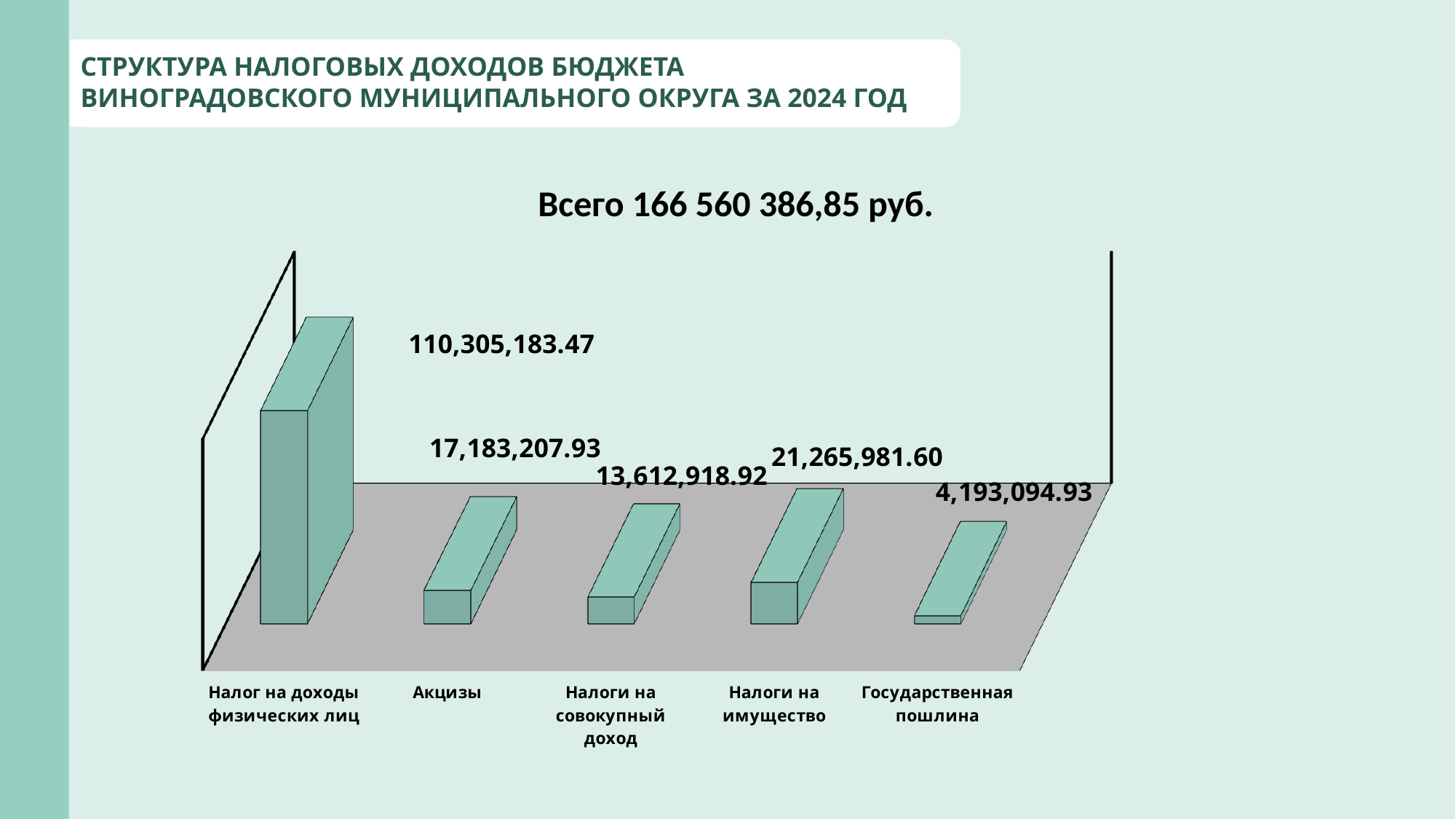
What is the value for Акцизы? 17,183,207.93 What is the difference between the values for Налог на доходы физических лиц and Государственная пошлина? 106,112,088.54 Which category has the lowest value? Государственная пошлина What is the value for Налоги на имущество? 21,265,981.60 How many categories are shown in the chart? 5 Which category has the highest value? Налог на доходы физических лиц What is the value for Государственная пошлина? 4,193,094.93 What is the value for Налог на доходы физических лиц? 110,305,183.47 What kind of chart is shown on the slide? Bar chart What is the value for Налоги на совокупный доход? 13,612,918.92 What is the difference between the values for Налоги на имущество and Акцизы? 4,082,773.67 Which is larger: the value for Акцизы or the value for Налоги на совокупный доход? Акцизы